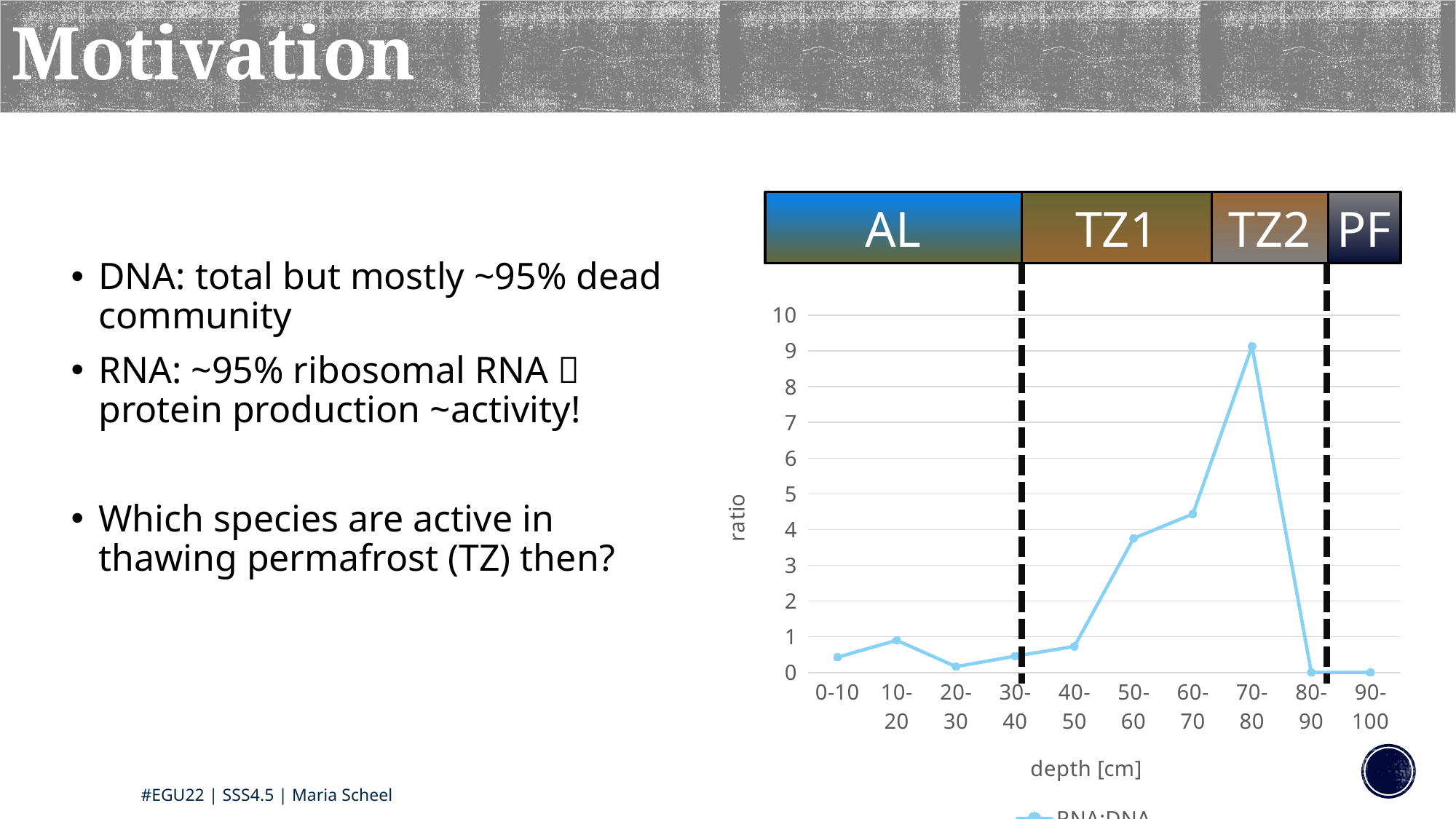
Is the value for the 40-50 depth category greater or less than 2? less Does the ratio rise or fall from the 70-80 depth category to the 80-90 depth category? fall What kind of chart is shown on the slide? line chart Which depth category has the highest ratio? 70-80 Which has the larger ratio, the 10-20 depth category or the 20-30 depth category? 10-20 What is the title of the x axis of the chart? depth [cm] How many depth categories are plotted along the x axis? 10 Is the value for the 70-80 depth category greater or less than 8? greater Is the value for the 50-60 depth category greater or less than 3? greater Which has the larger ratio, the 60-70 depth category or the 70-80 depth category? 70-80